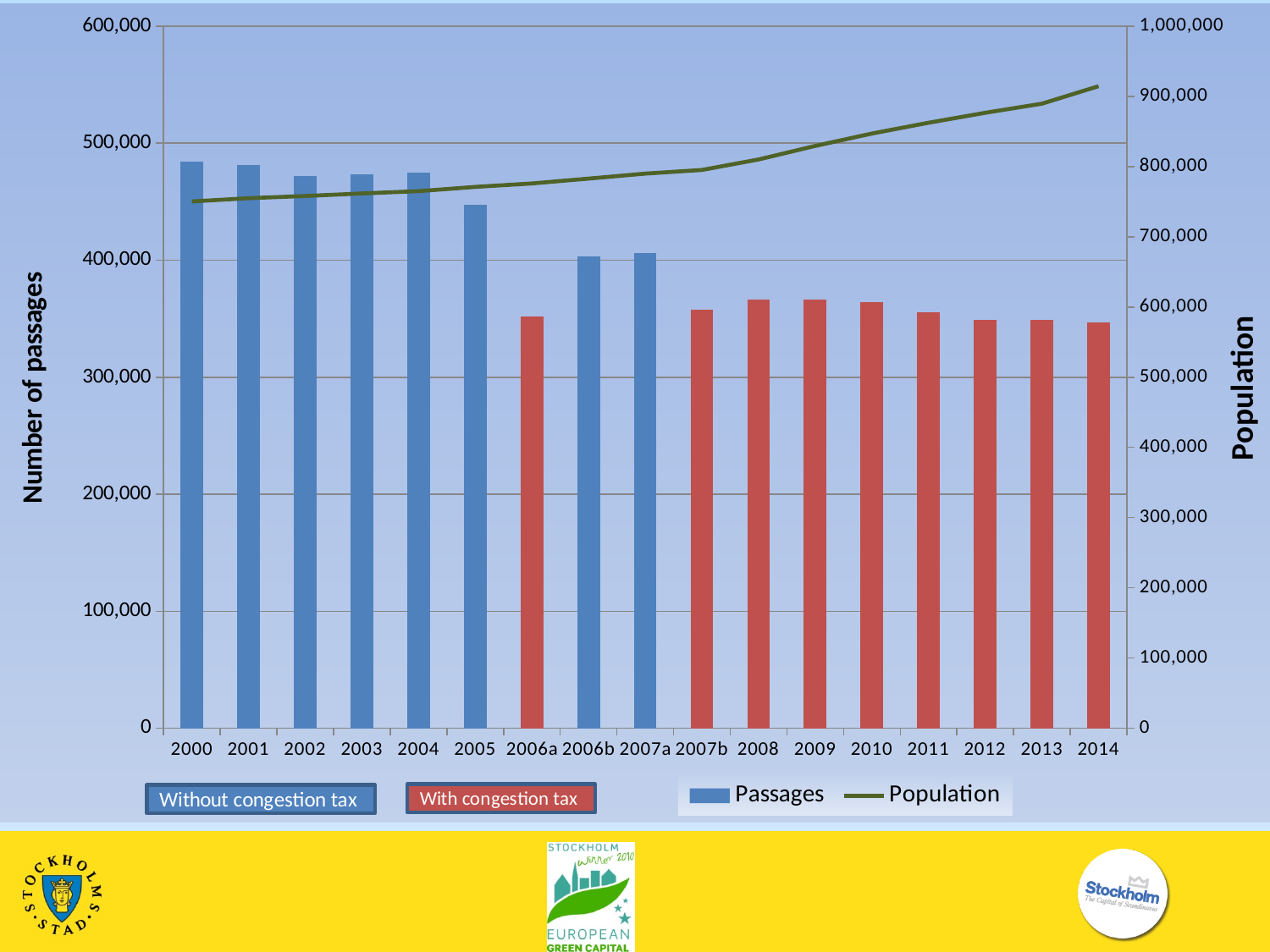
Does the Population line rise or fall from 2000 to 2014? rise Is the number of passages for 2000 greater or less than 400,000? greater Is the population value for 2000 greater or less than 800,000? less How many categories are shown on the x axis of the chart? 17 What does the red colour of the bars indicate according to the slide? With congestion tax Is the number of passages for 2014 greater or less than 400,000? less Which has more passages, 2005 or 2006a? 2005 How many series does the chart legend list? 2 What kind of chart is shown on the slide? Bar chart with a line Which has more passages, 2000 or 2014? 2000